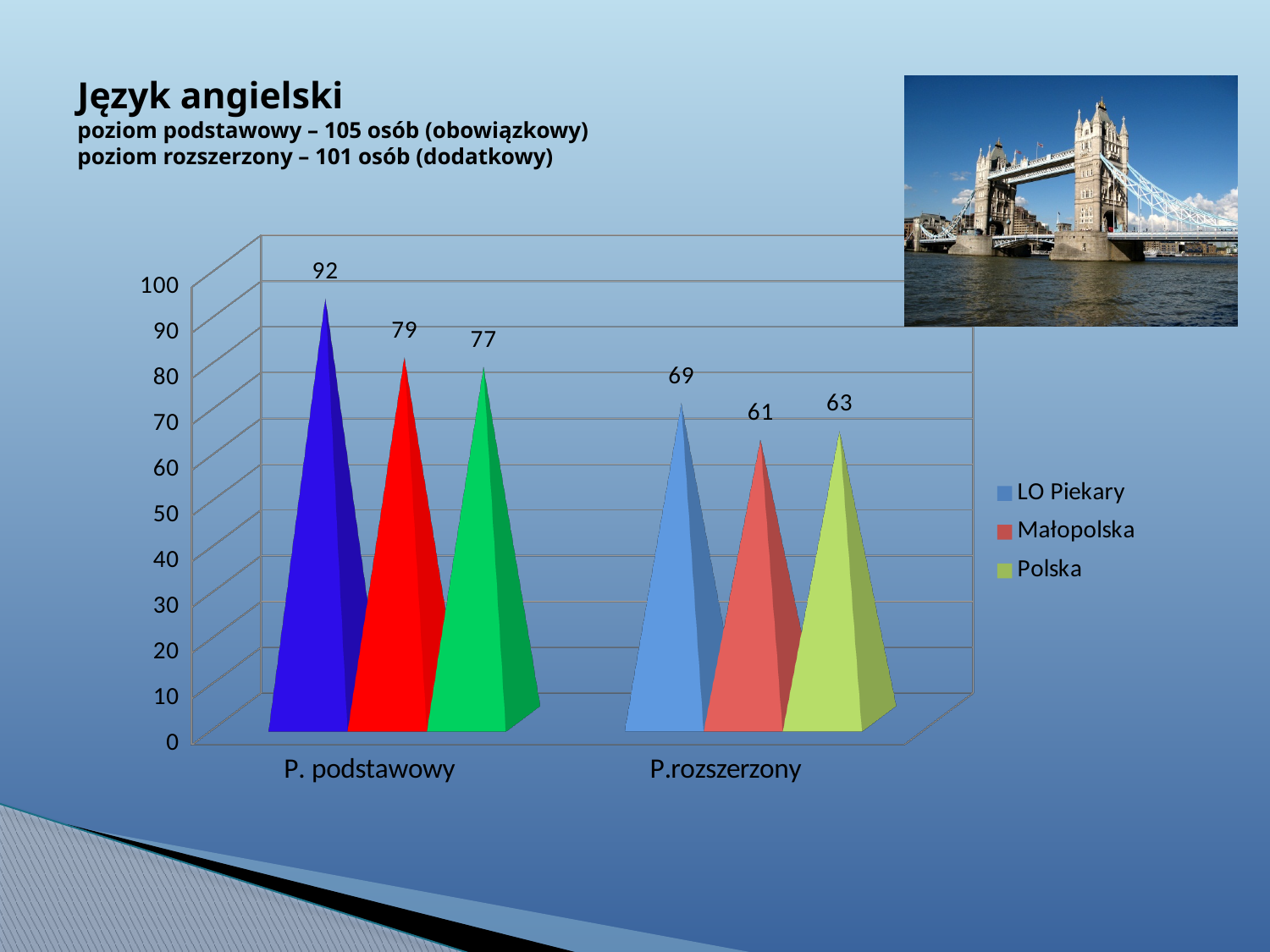
How many categories are shown on the x axis? 2 What kind of chart is shown on the slide? bar chart Which series is shown in red in the legend? Małopolska Which series has the lowest value in the P.rozszerzony category? Małopolska What is the value for Małopolska in the P.rozszerzony category? 61 Which series has the highest value in the P. podstawowy category? LO Piekary What is the value for LO Piekary in the P. podstawowy category? 92 How many series does the legend list? 3 What is the difference between the LO Piekary values for P. podstawowy and P.rozszerzony? 23 Which is larger: the Polska value for P. podstawowy or the Polska value for P.rozszerzony? P. podstawowy What is the value for LO Piekary in the P.rozszerzony category? 69 What is the value for Polska in the P. podstawowy category? 77